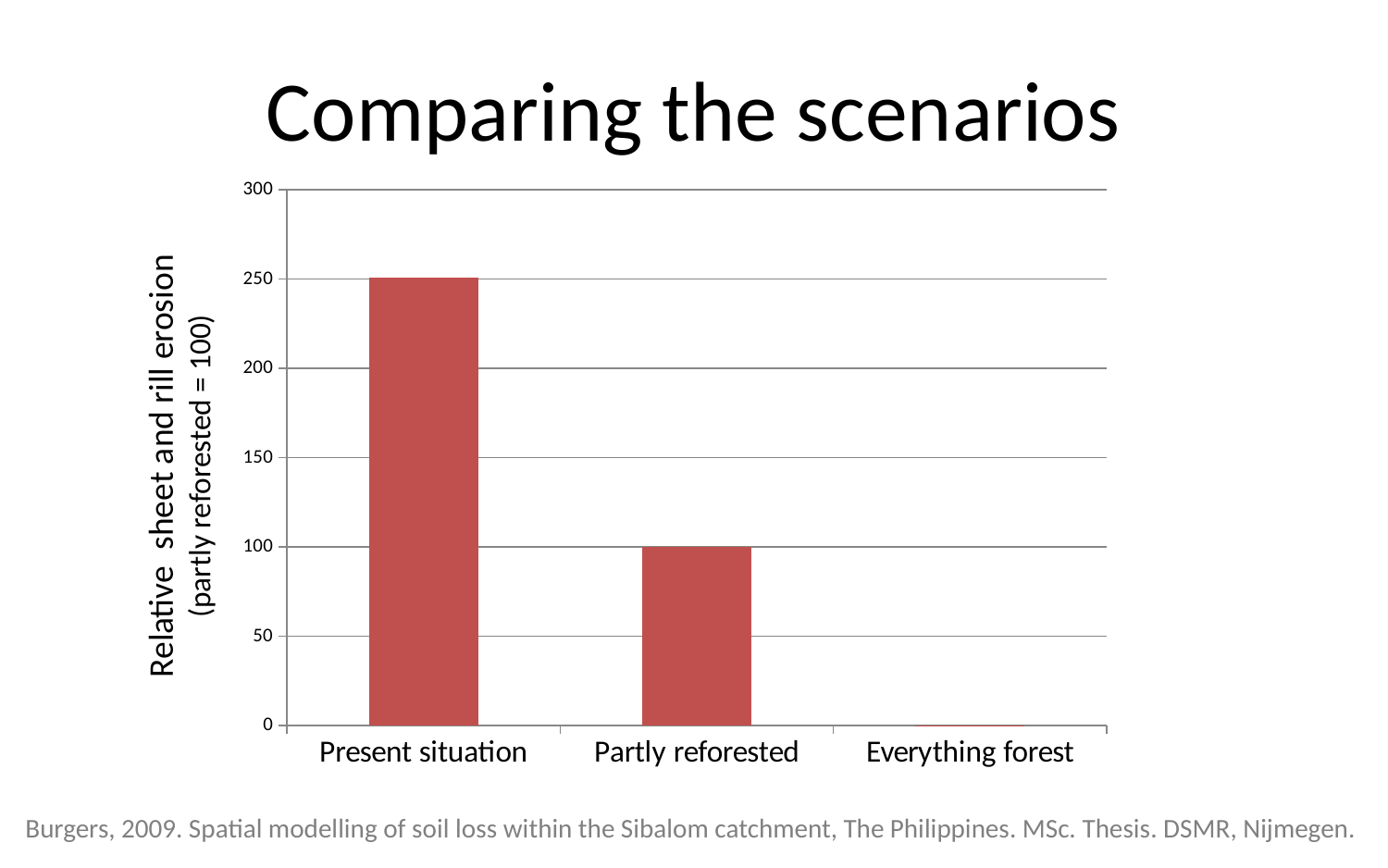
Which is larger, the value for Present situation or the value for Partly reforested? Present situation Is the value for Everything forest greater or less than 50? less How many scenarios (categories) are plotted on the x axis? 3 What is the label on the vertical axis? Relative sheet and rill erosion (partly reforested = 100) Which scenario has the lowest relative sheet and rill erosion? Everything forest Which scenario has the highest relative sheet and rill erosion? Present situation What kind of chart is shown on the slide? bar chart Is the value for Present situation greater or less than 300? less What is the relative sheet and rill erosion value for the Partly reforested scenario? 100 Is the value for Present situation greater or less than 200? greater Do the values rise or fall from left to right along the x axis? fall What is the title of the slide? Comparing the scenarios